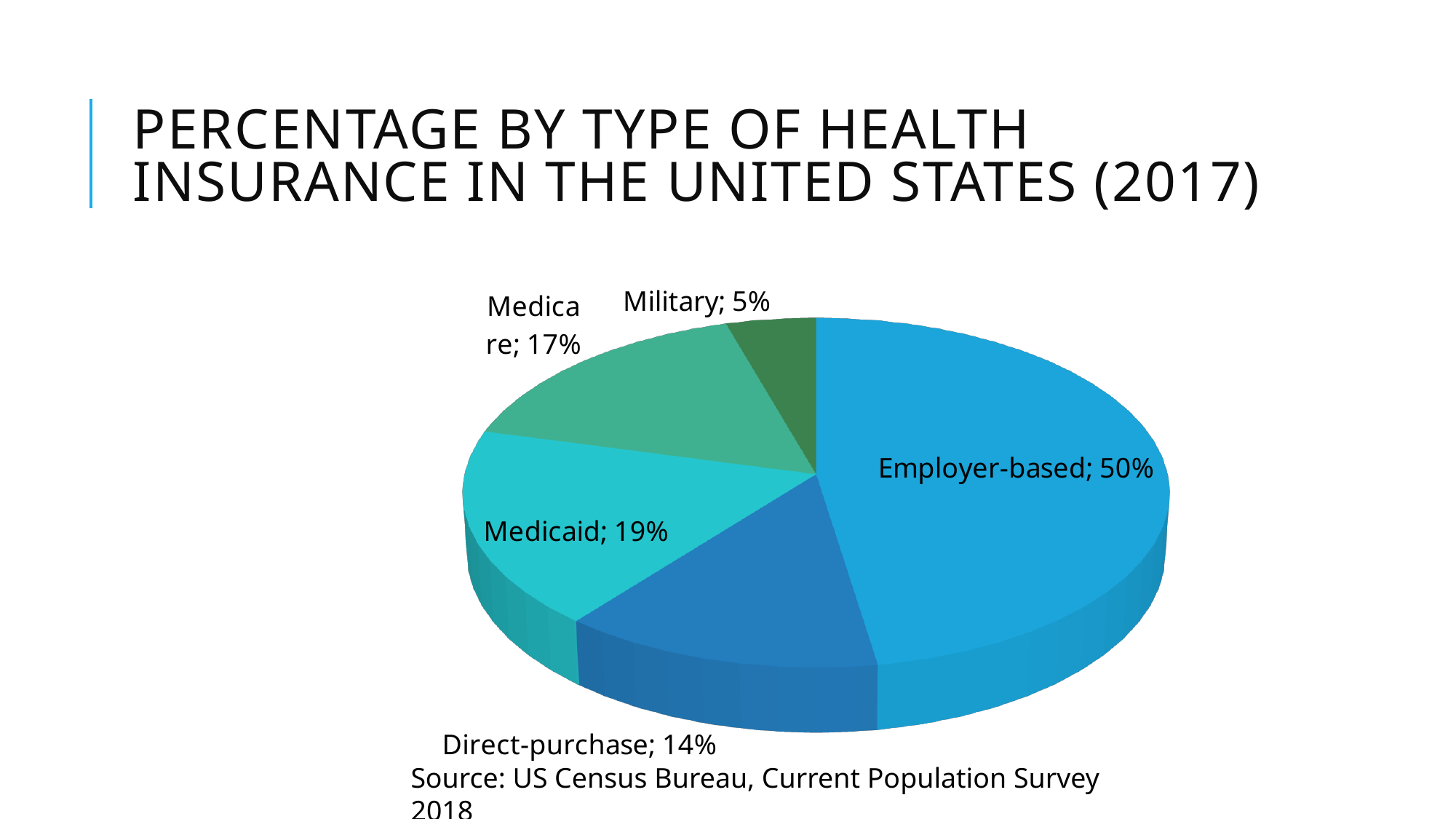
How many slices does the pie chart have? 5 What percentage is shown for Medicare? 17% What is the difference in percentage points between Employer-based and Medicaid? 31 What percentage of the pie is Employer-based? 50% What percentage is shown for Medicaid? 19% What percentage is shown for Direct-purchase? 14% Which type of health insurance has the largest share? Employer-based Which is larger, Medicaid or Medicare? Medicaid What is the source cited below the chart? US Census Bureau, Current Population Survey 2018 What kind of chart is shown on the slide? Pie chart Which type of health insurance has the smallest share? Military What percentage is shown for Military? 5%